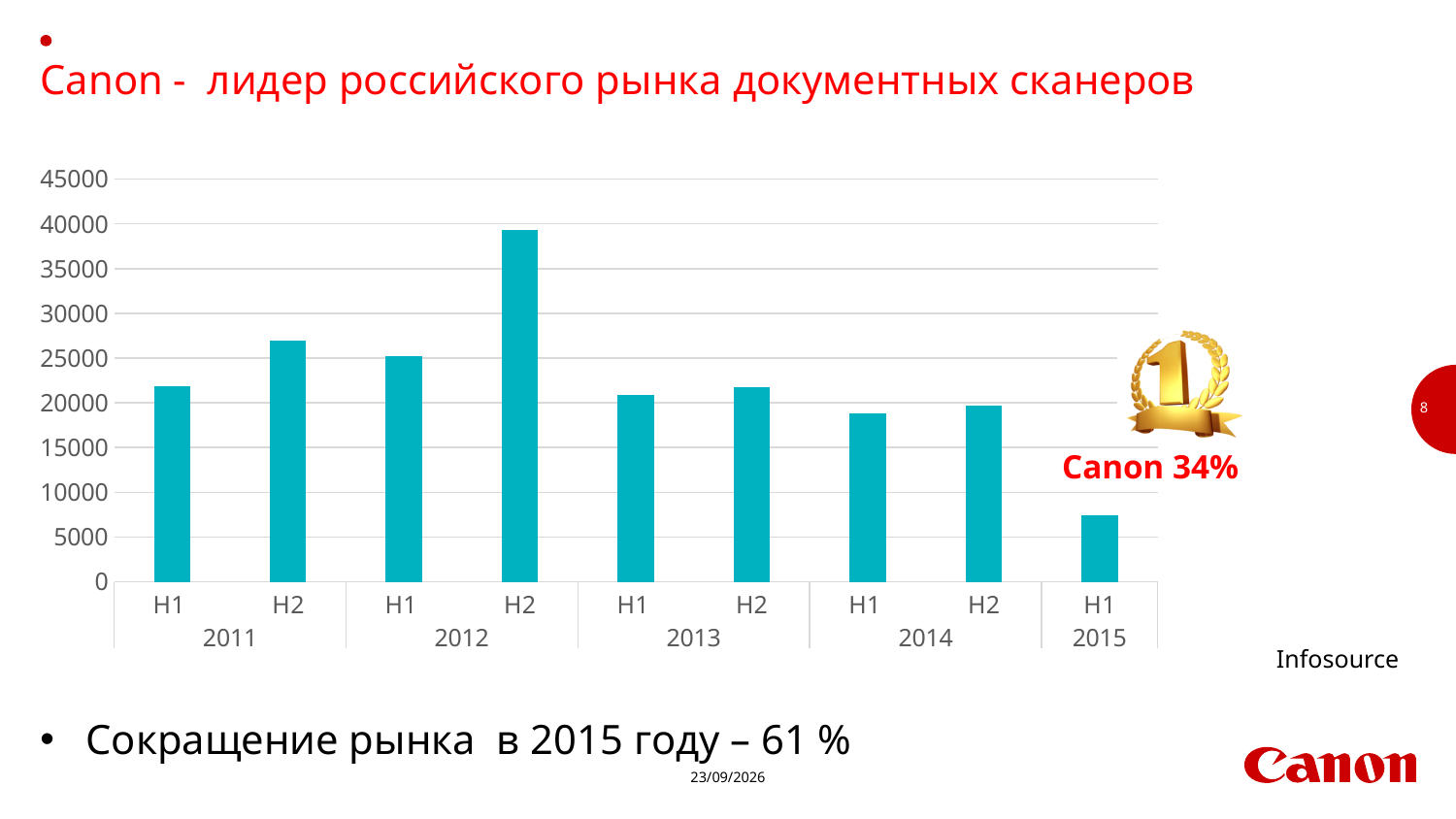
Which is larger, the value for H2 2011 or the value for H1 2013? H2 2011 How many bars are plotted in the chart? 9 Do the values rise or fall from H2 2012 to H1 2015? fall What market share for Canon is annotated on the chart? Canon 34% Is the value for H1 2011 greater or less than 20000? greater Which period has the lowest value in the chart? H1 2015 Is the value for H1 2014 greater or less than 20000? less Is the value for H2 2011 greater or less than 25000? greater What kind of chart is shown on the slide? bar chart Which period has the highest value in the chart? H2 2012